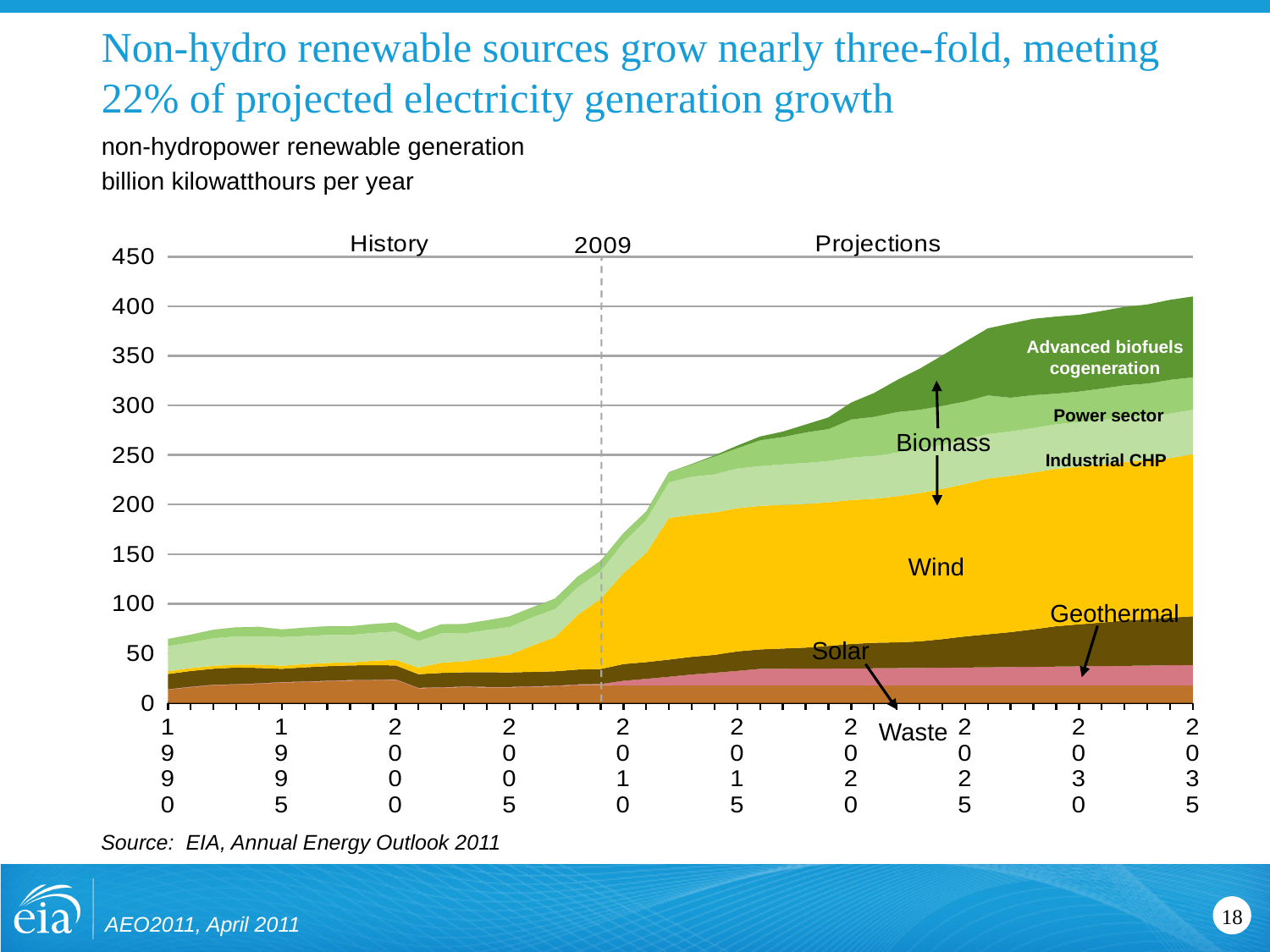
Which year does the dashed vertical line separating History from Projections mark? 2009 What kind of chart is shown on the slide? stacked area chart What is the unit of measurement shown for the y axis of the chart? billion kilowatthours per year In 2035, which is larger: the Wind area or the Geothermal area? Wind Does total non-hydropower renewable generation rise or fall between 2009 and 2035? rise Is the total non-hydropower renewable generation in 2020 greater or less than 250? greater Is the total non-hydropower renewable generation in 1990 greater or less than 100? less Which source contributes the largest share of non-hydropower renewable generation in 2035? Wind Is the total non-hydropower renewable generation in 2035 greater or less than 400? greater How many year labels are shown on the x axis? 10 Which source is shown at the bottom of the stacked areas? Waste